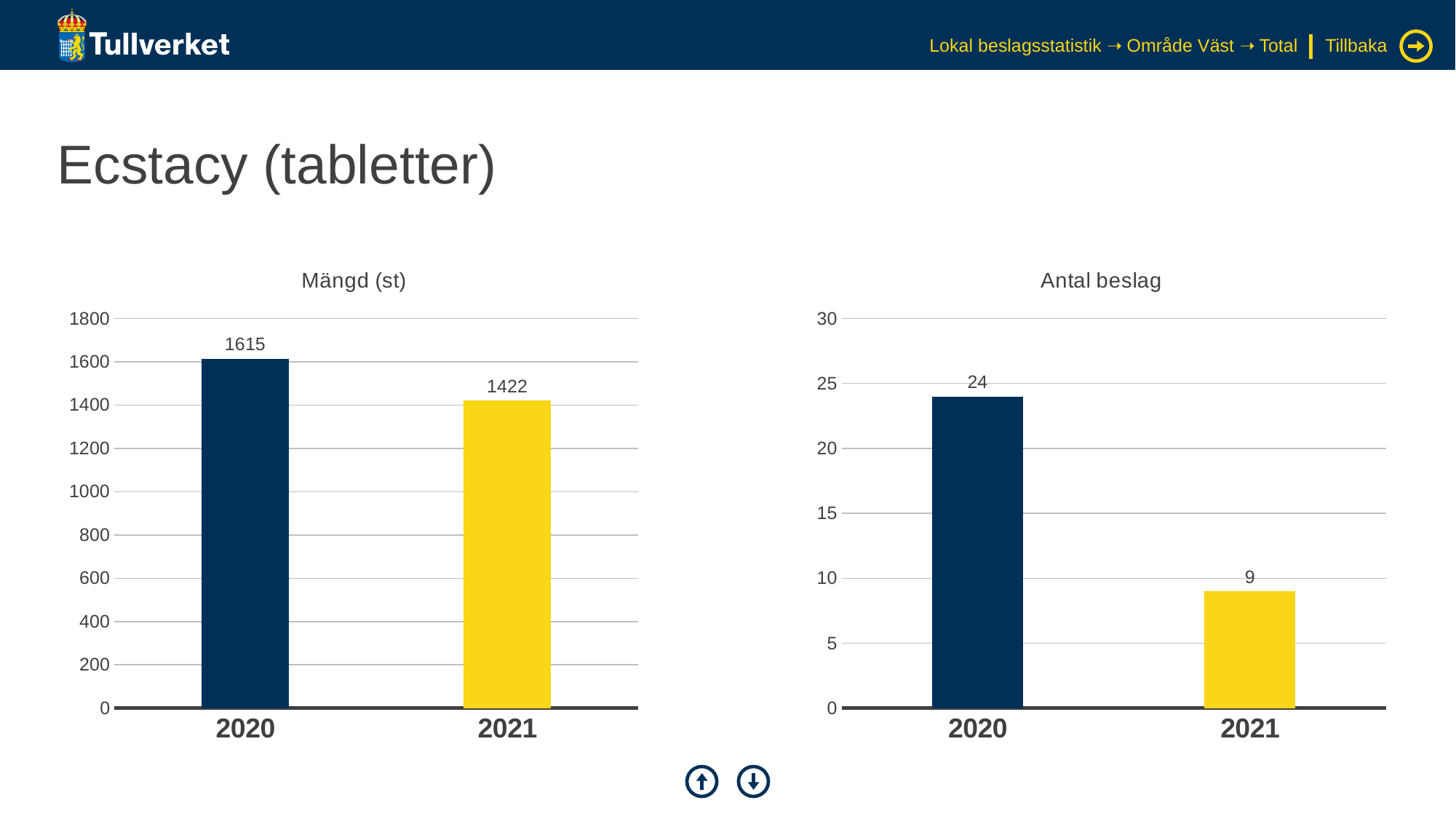
In the "Antal beslag" chart, which year has the lowest value? 2021 In the "Antal beslag" chart, is the value for 2020 greater or less than 20? greater What kind of chart is the "Antal beslag" chart? bar chart How many categories are shown on the x axis of the "Mängd (st)" chart? 2 In the "Mängd (st)" chart, what is the value for 2020? 1615 In the "Mängd (st)" chart, what is the difference between the 2020 and 2021 values? 193 In the "Mängd (st)" chart, which year has the highest value? 2020 In the "Antal beslag" chart, what is the value for 2021? 9 In the "Antal beslag" chart, what is the difference between the 2020 and 2021 values? 15 In the "Antal beslag" chart, do the values rise or fall from 2020 to 2021? fall In the "Antal beslag" chart, what is the value for 2020? 24 In the "Mängd (st)" chart, what is the value for 2021? 1422